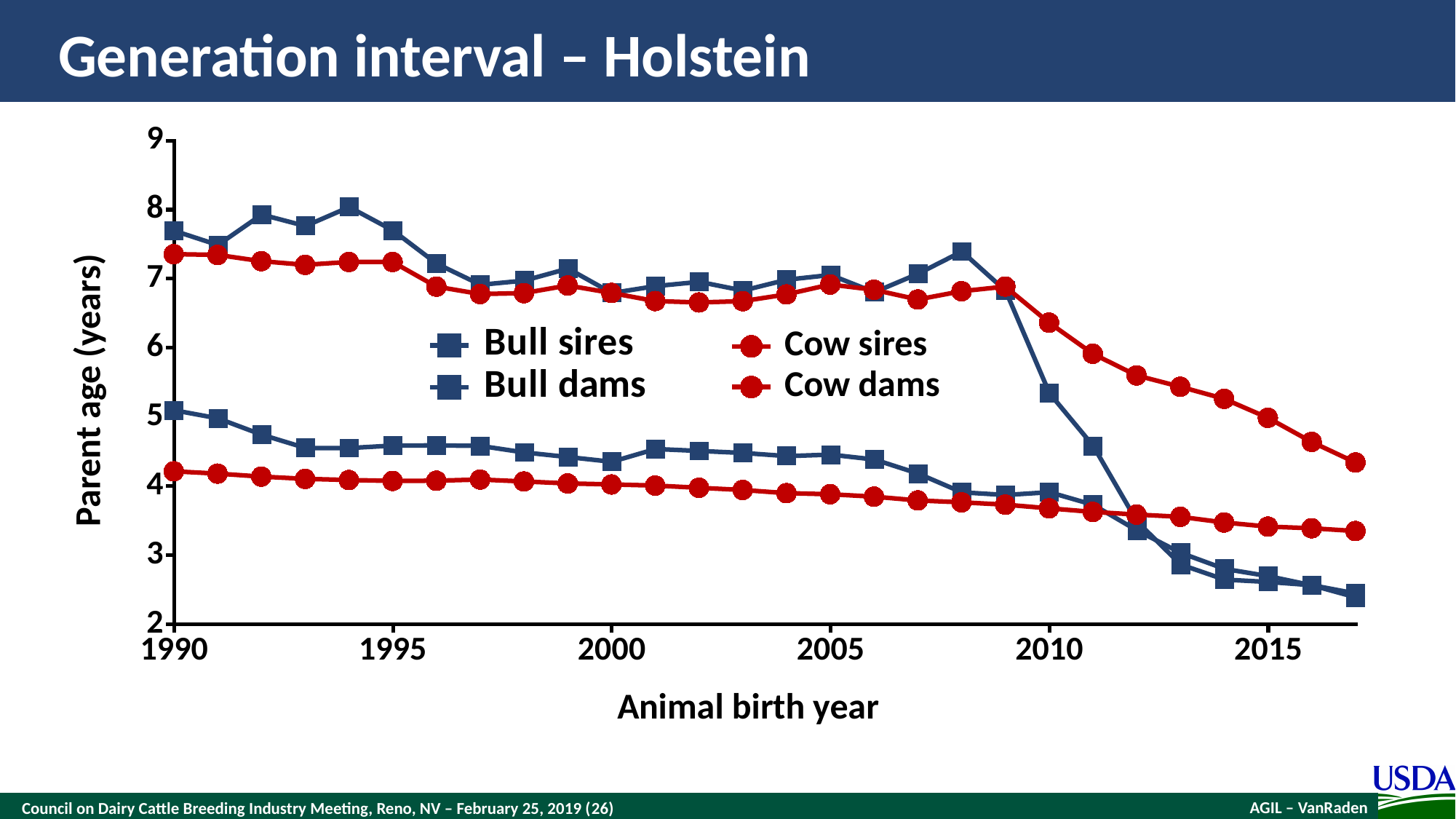
In 2017, which is larger: Cow sires or Bull sires? Cow sires How many series does the legend list? 4 What is the label of the y axis? Parent age (years) In 1990, which is larger: Bull sires or Cow sires? Bull sires Is the value for Bull sires in 2010 greater or less than 6? less What kind of chart is shown on the slide? line chart Which series has the highest value in 2017? Cow sires Is the value for Bull sires in 1990 greater or less than 7? greater Is the value for Bull dams in 2017 greater or less than 3? less Do the values for Bull sires rise or fall from 2009 to 2017? fall What is the title of the chart? Generation interval – Holstein